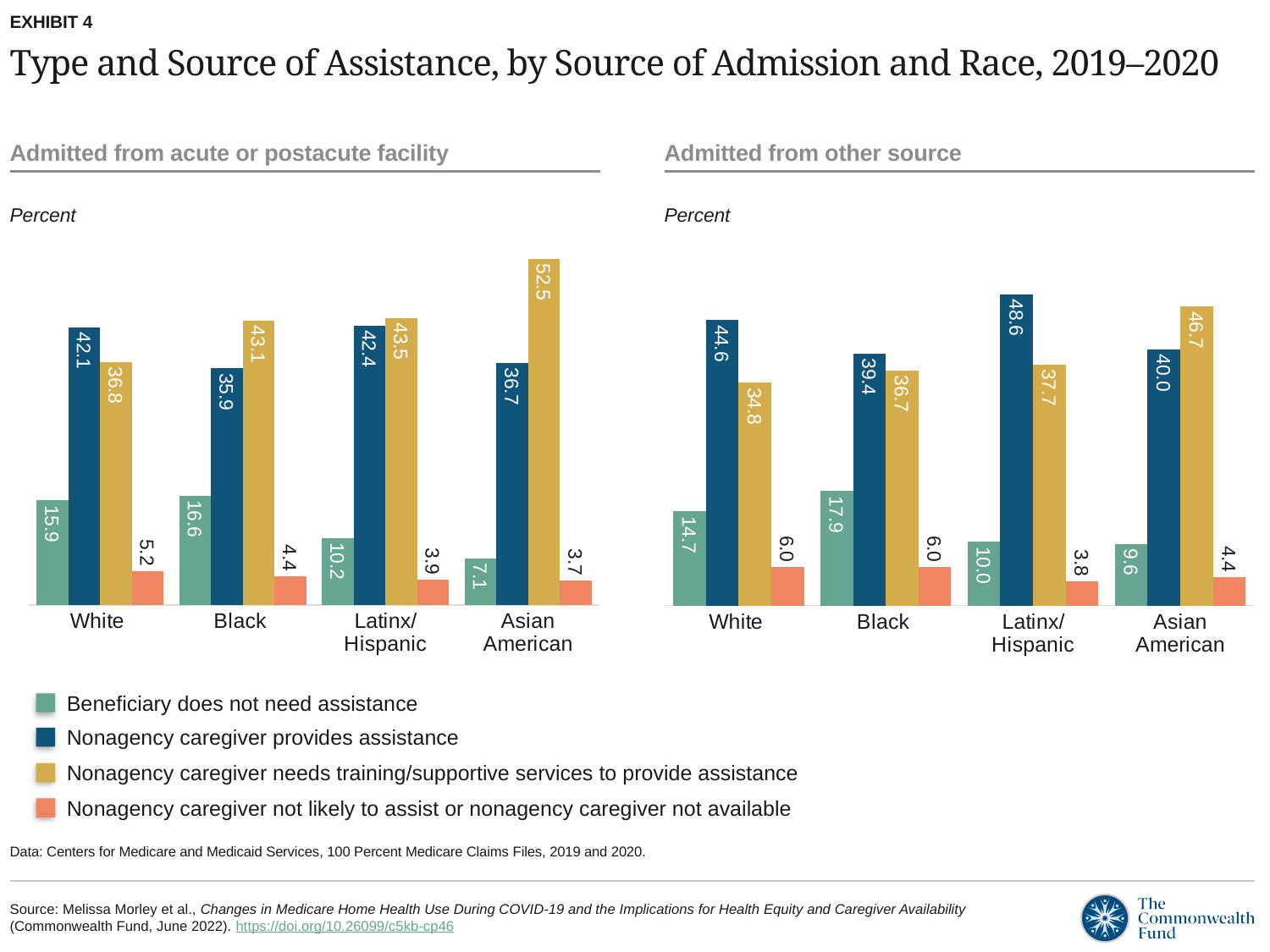
In the 'Admitted from other source' chart, which race group has the lowest value for 'Nonagency caregiver not likely to assist or nonagency caregiver not available'? Latinx/Hispanic In the 'Admitted from acute or postacute facility' chart, what is the difference between the 'Nonagency caregiver provides assistance' values for White and Black? 6.2 In the 'Admitted from other source' chart, which is larger for Asian American: 'Nonagency caregiver provides assistance' or 'Nonagency caregiver needs training/supportive services to provide assistance'? Nonagency caregiver needs training/supportive services to provide assistance In the 'Admitted from other source' chart, what is the value for 'Nonagency caregiver provides assistance' for Latinx/Hispanic? 48.6 In the 'Admitted from acute or postacute facility' chart, what is the value for 'Nonagency caregiver needs training/supportive services to provide assistance' for Asian American? 52.5 In the 'Admitted from other source' chart, what is the value for 'Beneficiary does not need assistance' for Black? 17.9 In the 'Admitted from acute or postacute facility' chart, which race group has the highest value for 'Beneficiary does not need assistance'? Black What unit is shown on the y axis label of both charts? Percent How many series does the legend list? 4 What kind of chart is the 'Admitted from acute or postacute facility' chart? Bar chart How many race groups are shown on the x axis of the 'Admitted from other source' chart? 4 In the 'Admitted from acute or postacute facility' chart, what is the difference between the 'Beneficiary does not need assistance' values for White and Asian American? 8.8